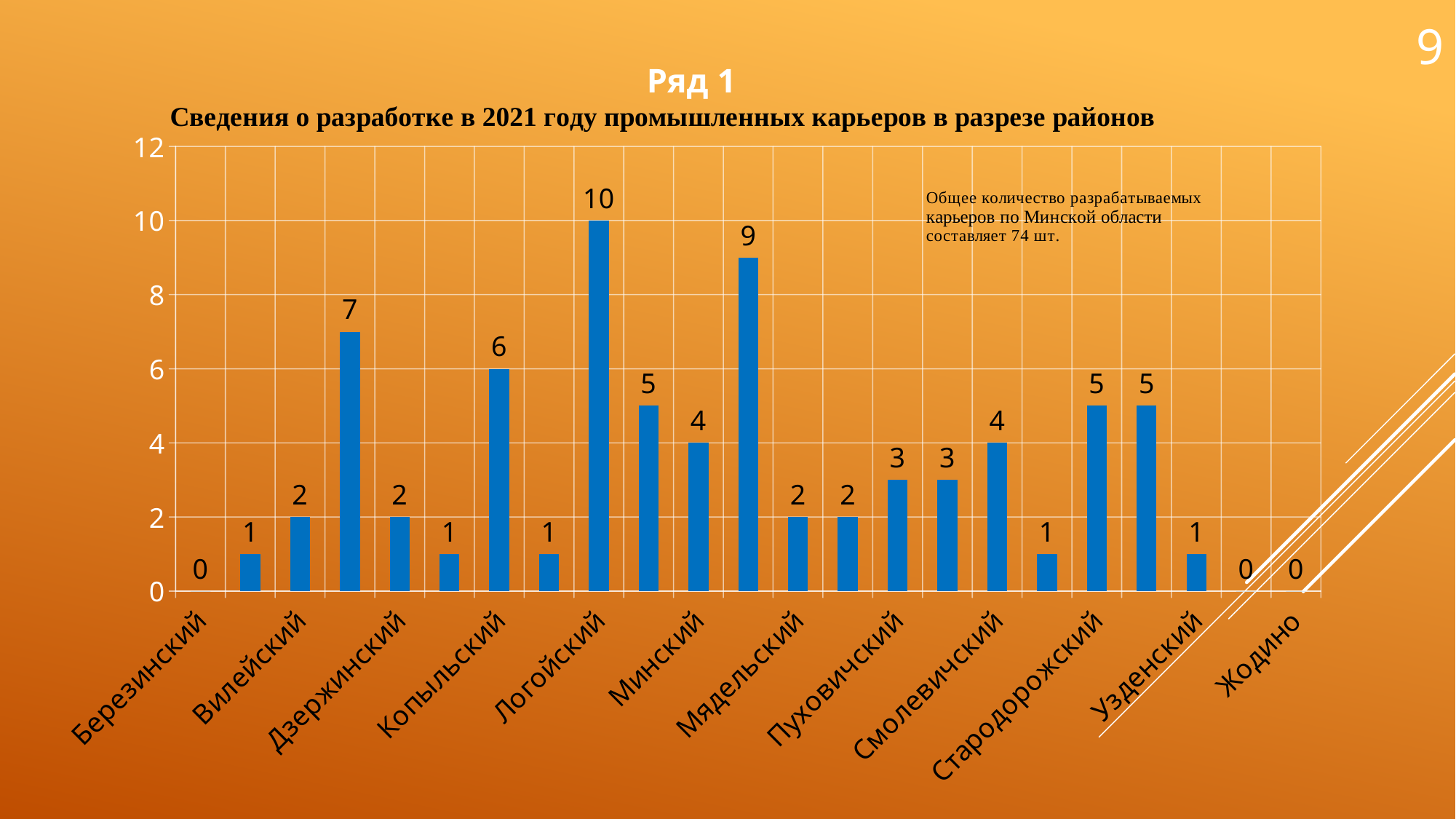
What is the value for Стародорожский? 5 According to the text box on the chart, what is the total number of quarries being developed in the Minsk region? 74 шт. What is the value for Копыльский? 6 Which labelled district has the highest value? Логойский Which is larger, the value for Пуховичский or the value for Смолевичский? Смолевичский What is the value for Минский? 4 What is the highest value shown on the vertical axis? 12 How many bars are plotted in the chart? 23 What is the difference between the values for Логойский and Копыльский? 4 What is the value for Логойский? 10 What kind of chart is shown on the slide? Bar chart What is the value for Жодино? 0